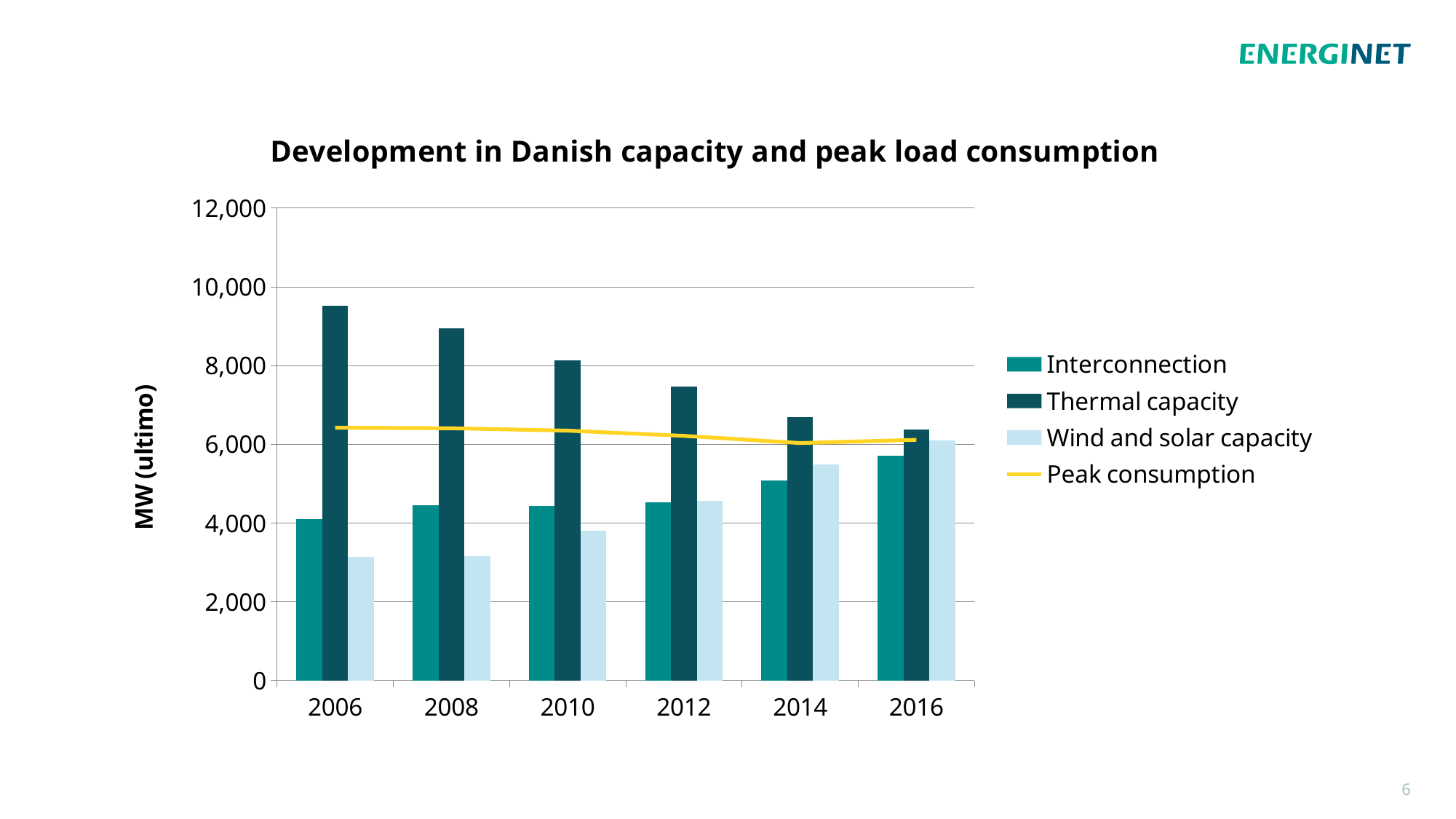
Does Wind and solar capacity rise or fall from 2006 to 2016? Rise What kind of chart is shown on the slide? A bar chart with a line series In which year is Wind and solar capacity highest? 2016 How many years are shown on the x axis? 6 In which year is Interconnection lowest? 2006 In which year is Thermal capacity lowest? 2016 Does Thermal capacity rise or fall from 2006 to 2016? Fall What is the label on the y axis? MW (ultimo) In which year is Thermal capacity highest? 2006 Is the Wind and solar capacity value for 2006 greater or less than 4,000? less How many series does the legend list? 4 Is the Thermal capacity value for 2006 greater or less than 8,000? greater